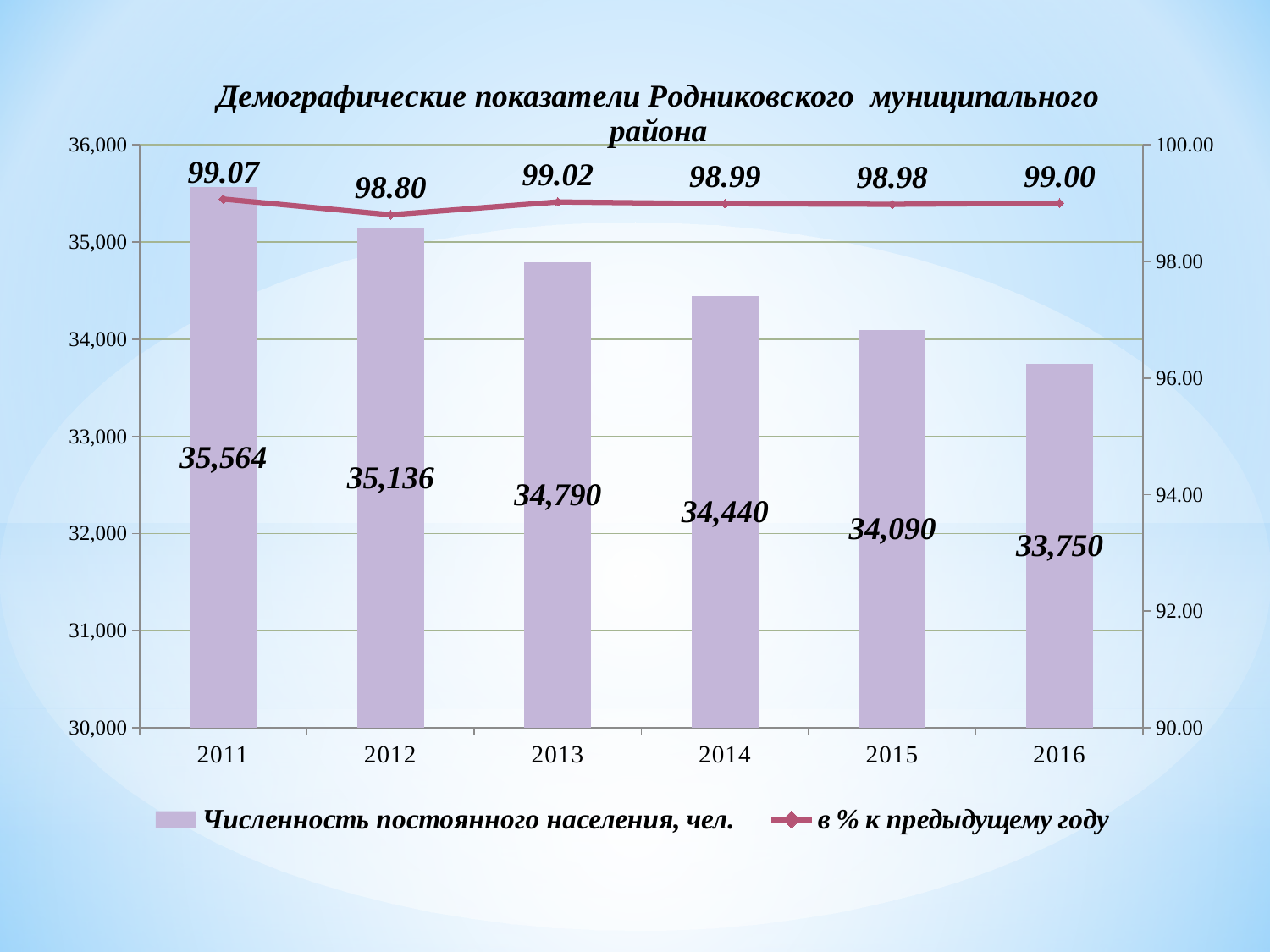
How many series does the legend list? 2 What is the value of в % к предыдущему году for 2012? 98.80 How many years are shown on the x axis? 6 Which is larger, the Численность постоянного населения, чел. value for 2013 or for 2014? 2013 Which year has the lowest value of в % к предыдущему году? 2012 Which year has the highest value of Численность постоянного населения, чел.? 2011 What is the value of Численность постоянного населения, чел. for 2011? 35,564 Does the Численность постоянного населения, чел. series rise or fall from 2011 to 2016? fall What is the value of Численность постоянного населения, чел. for 2016? 33,750 Is the value of Численность постоянного населения, чел. for 2015 greater or less than 34,000? greater What is the difference between the Численность постоянного населения, чел. values for 2011 and 2016? 1,814 What is the title of the chart? Демографические показатели Родниковского муниципального района